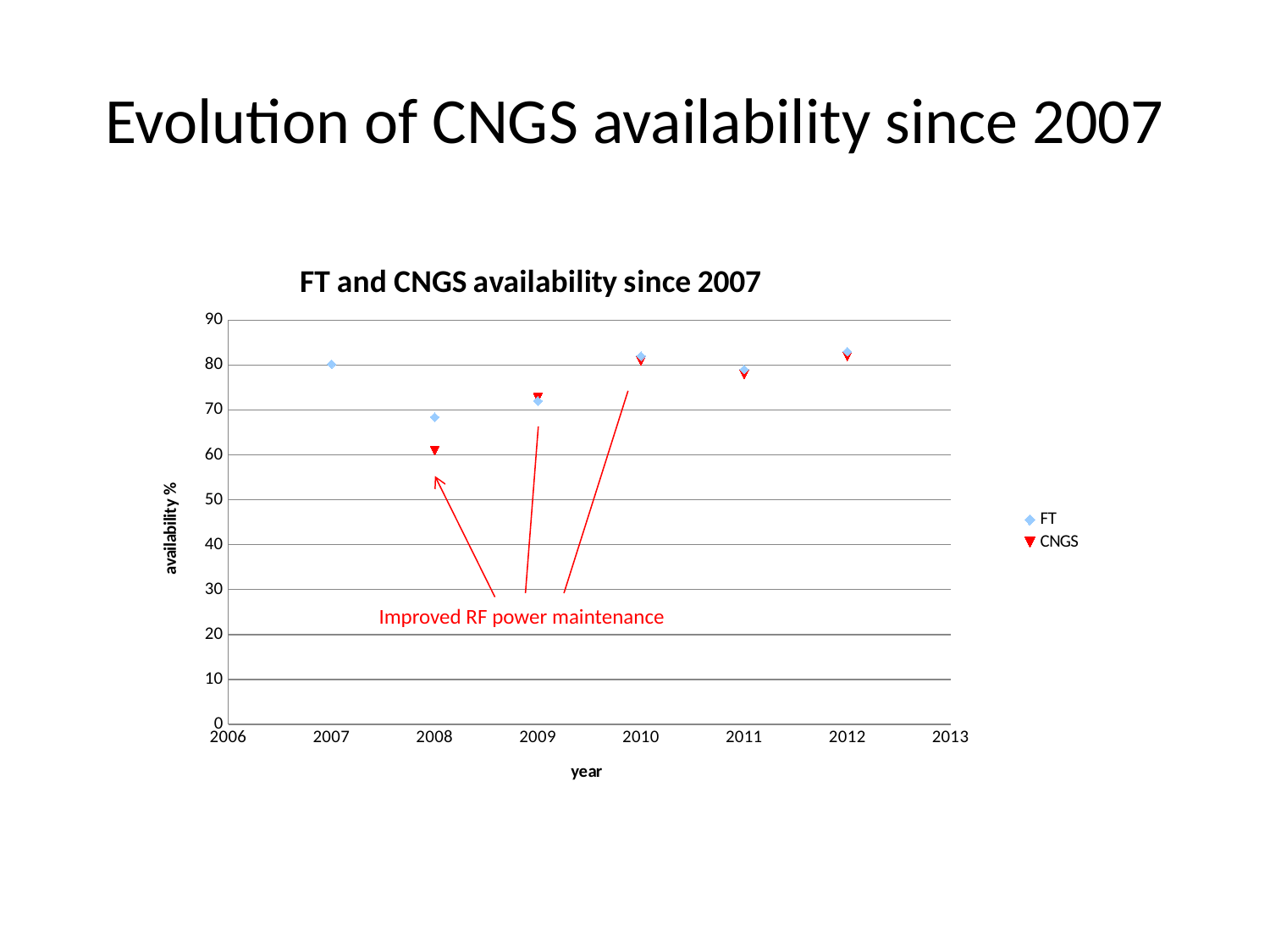
In which year is the FT availability lowest? 2008 Does the CNGS availability rise or fall from 2008 to 2010? rise How many data points are plotted for the FT series? 6 What kind of chart is shown on the slide? scatter chart How many series does the legend list? 2 Is the CNGS availability for 2009 greater or less than 70? greater Is the CNGS availability for 2008 greater or less than 70? less What are the two series named in the legend? FT and CNGS What is the title of the chart? FT and CNGS availability since 2007 In which year is the CNGS availability lowest? 2008 Is the FT availability for 2010 greater or less than 80? greater In 2008, which series has the higher availability, FT or CNGS? FT